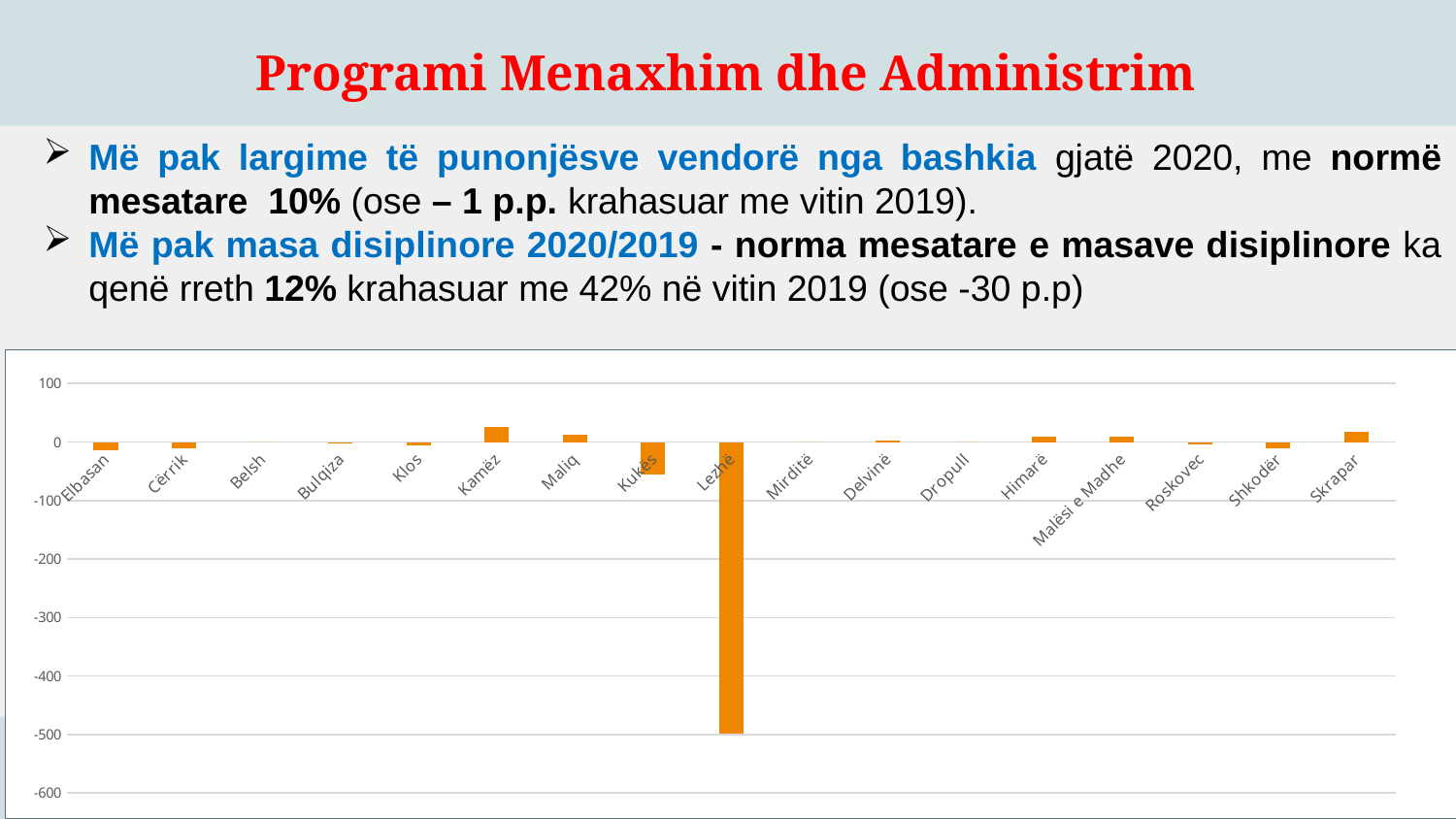
What kind of chart is shown on the slide? bar chart How many categories (municipalities) are shown on the x axis of the chart? 17 Is the value for Kukës greater or less than -100? greater What is the lowest value shown on the vertical axis of the chart? -600 Which has the larger value, Kukës or Lezhë? Kukës Is the value for Kukës greater or less than 0? less Which has the larger value, Kamëz or Kukës? Kamëz Which category has the highest value in the chart? Kamëz Is the value for Kamëz greater or less than 0? greater Which category has the lowest value in the chart? Lezhë What colour are the bars in the chart? orange